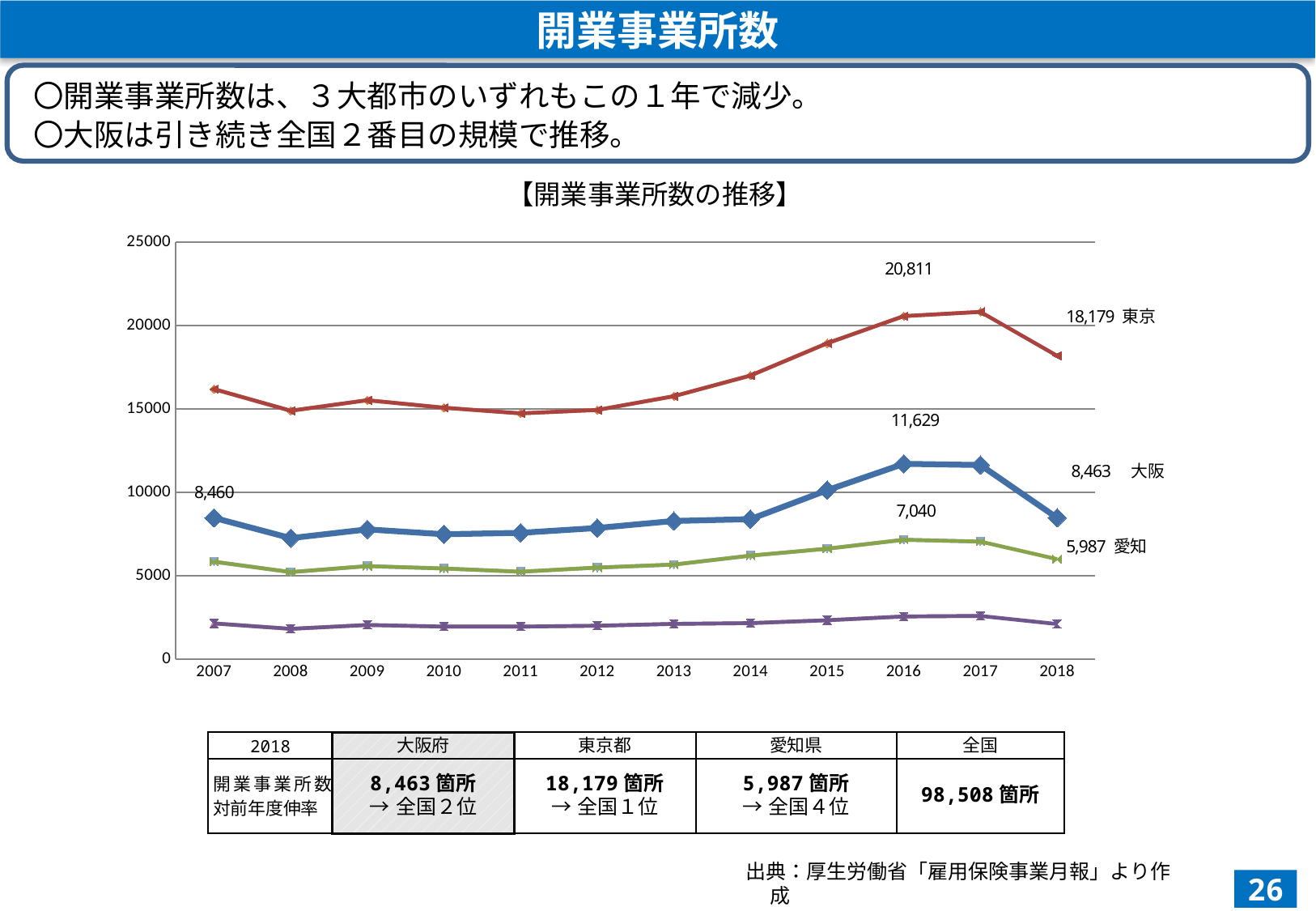
Is the value for 東京 in 2014 greater or less than 15000? greater How many years are shown on the x axis? 12 What kind of chart is shown on the slide? line chart What is the value for 大阪 in 2007? 8,460 What is the value for 大阪 in 2018? 8,463 Which is larger in 2018, the value for 東京 or the value for 大阪? 東京 What is the value for 東京 in 2017? 20,811 What is the difference between the 東京 values in 2017 and 2018? 2,632 What is the value for 愛知 in 2018? 5,987 What is the value for 東京 in 2018? 18,179